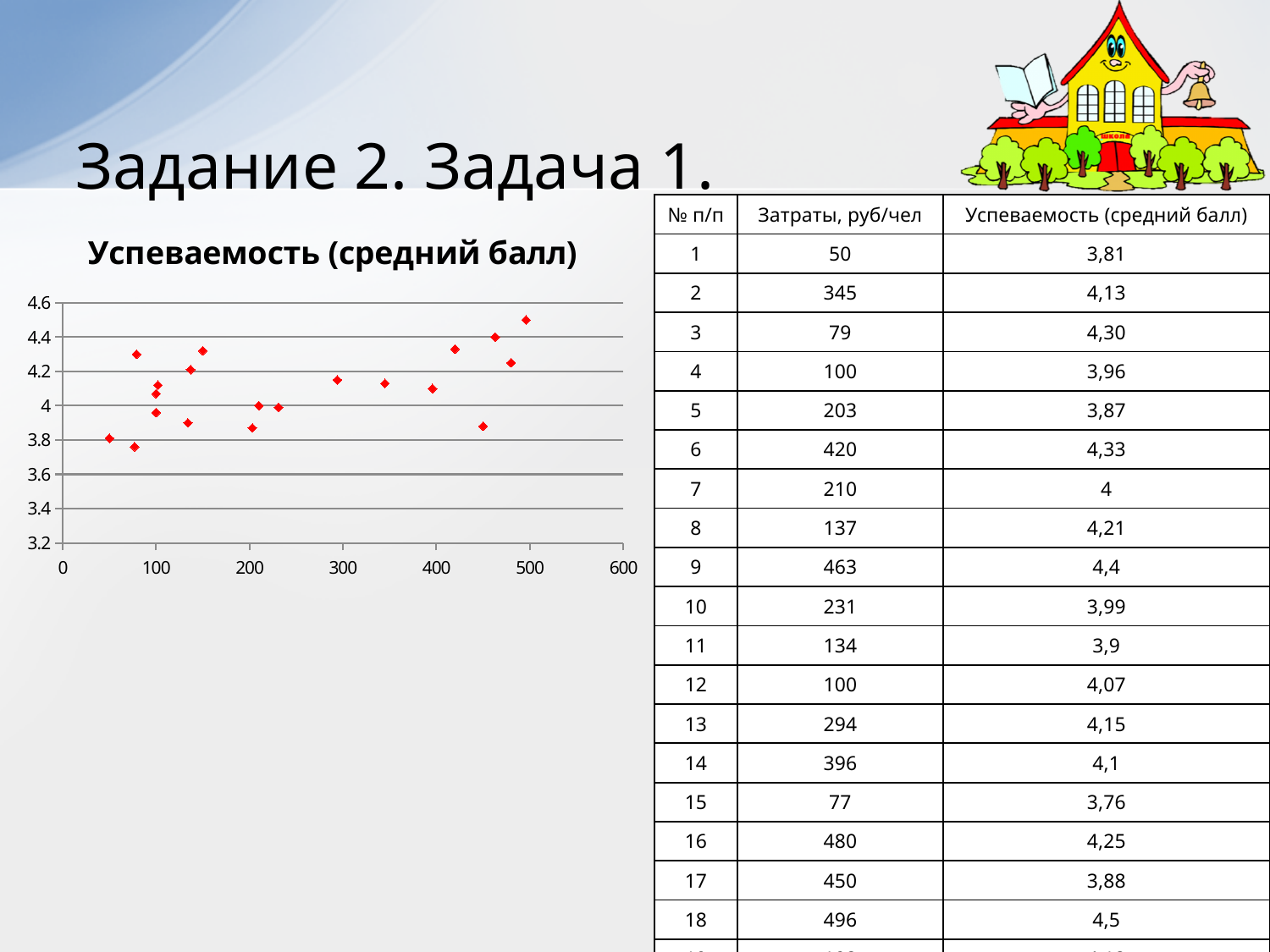
Do the plotted values generally rise or fall as x increases along the chart? rise Is the value of the point near x = 500 greater or less than 4.4? greater What is the highest value shown on the chart's x axis? 600 Is the value of the point at x = 450 greater or less than 4? less According to the table on the slide, what is the успеваемость (средний балл) for затраты of 496 руб/чел? 4,5 According to the table on the slide, what is the difference between the успеваемость for затраты of 496 and for затраты of 50? 0,69 Is the value of the point at x = 50 greater or less than 4? less Which point has the highest value on the chart: the one near x = 500 or the one near x = 300? the one near x = 500 What is the title of the chart? Успеваемость (средний балл) According to the table on the slide, what is the успеваемость (средний балл) for затраты of 420 руб/чел? 4,33 What kind of chart is shown on the slide? scatter chart